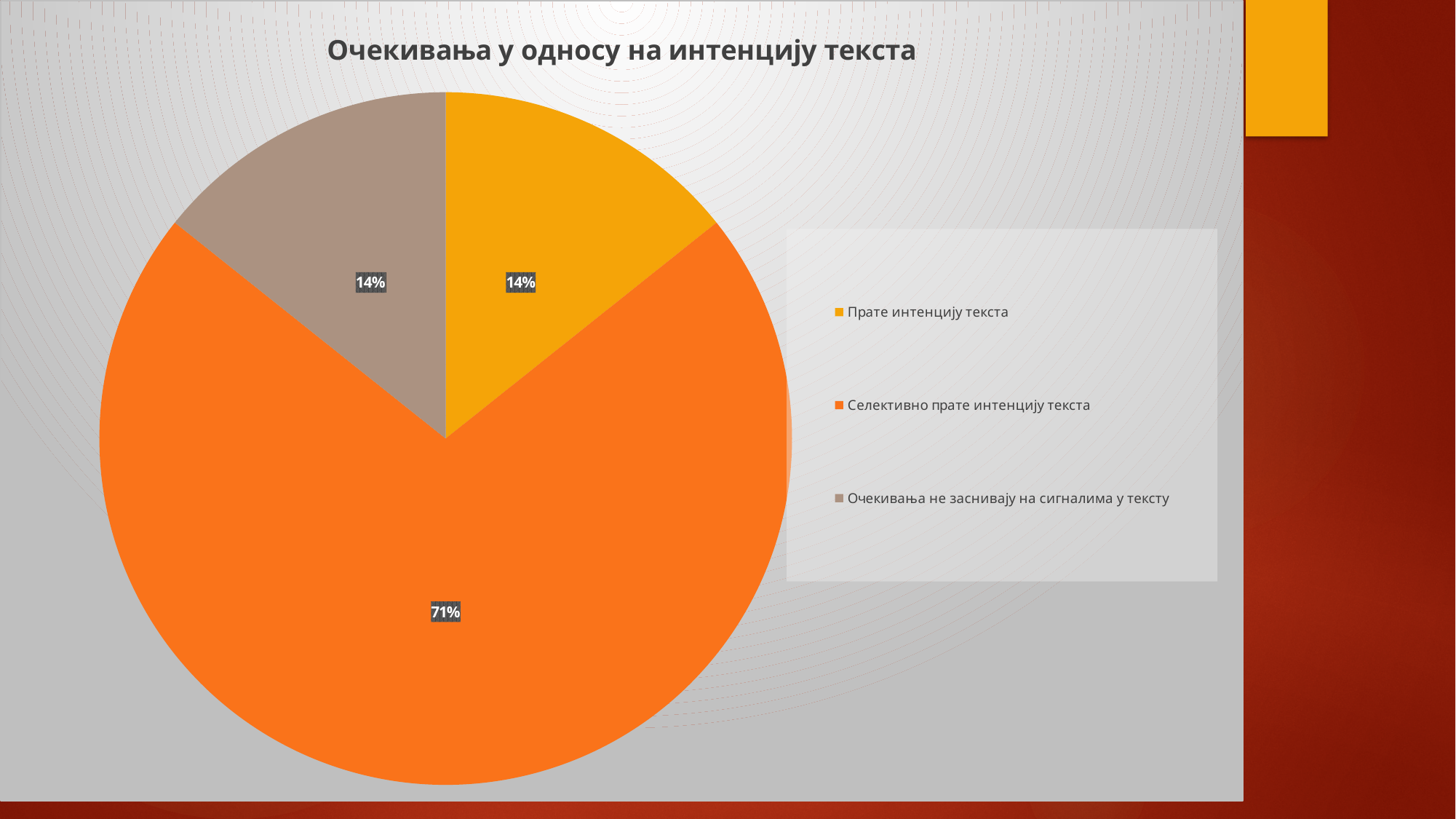
Which legend entry is shown in grey-brown? Очекивања не заснивају на сигналима у тексту What share of the pie is labelled "Прате интенцију текста"? 14% What is the title of the chart? Очекивања у односу на интенцију текста How many slices does the pie chart have? 3 What is the difference in percentage points between "Селективно прате интенцију текста" and "Прате интенцију текста"? 57 What share of the pie is labelled "Очекивања не заснивају на сигналима у тексту"? 14% What share of the pie is labelled "Селективно прате интенцију текста"? 71% Which category has the largest slice of the pie? Селективно прате интенцију текста Which is larger: the slice for "Селективно прате интенцију текста" or the slice for "Очекивања не заснивају на сигналима у тексту"? Селективно прате интенцију текста Is the share for "Селективно прате интенцију текста" greater or less than 50%? greater What kind of chart is shown on the slide? pie chart